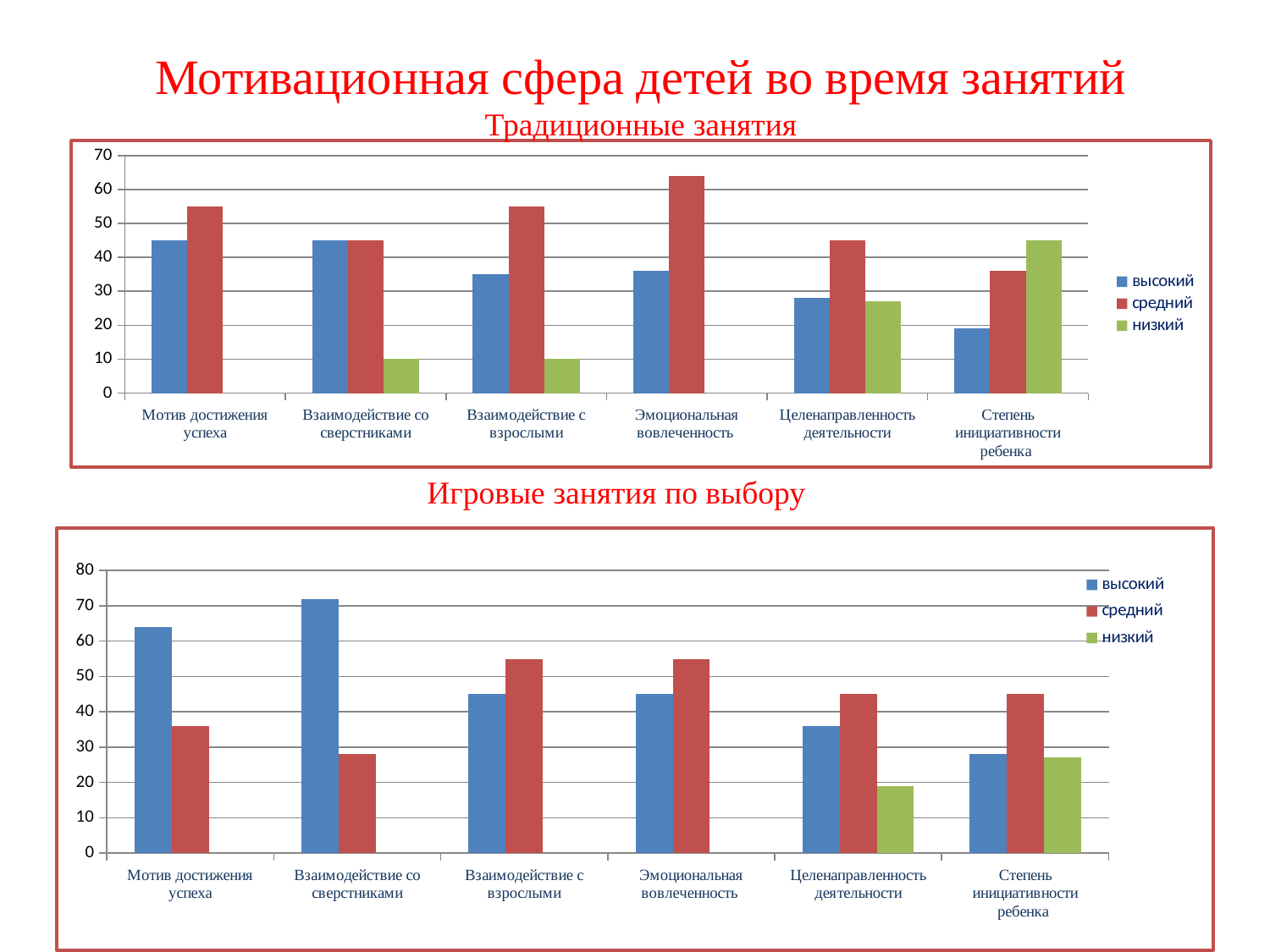
What colour represents the "низкий" series in the "Традиционные занятия" chart? green In the "Традиционные занятия" chart, which category has the highest "средний" bar? Эмоциональная вовлеченность In the "Игровые занятия по выбору" chart, is the "низкий" value for "Целенаправленность деятельности" greater or less than 30? less In the "Традиционные занятия" chart, for "Мотив достижения успеха", which is larger: "высокий" or "средний"? средний In the "Игровые занятия по выбору" chart, which category has the highest "высокий" bar? Взаимодействие со сверстниками How many series does the legend of the "Игровые занятия по выбору" chart list? 3 In the "Игровые занятия по выбору" chart, is the "высокий" value for "Взаимодействие со сверстниками" greater or less than 60? greater What type of chart is used for "Традиционные занятия"? bar chart How many categories are shown on the x axis of the "Традиционные занятия" chart? 6 In the "Игровые занятия по выбору" chart, for "Мотив достижения успеха", which is larger: "высокий" or "средний"? высокий In the "Традиционные занятия" chart, is the "средний" value for "Эмоциональная вовлеченность" greater or less than 60? greater In the "Традиционные занятия" chart, which category has the lowest "высокий" bar? Степень инициативности ребенка